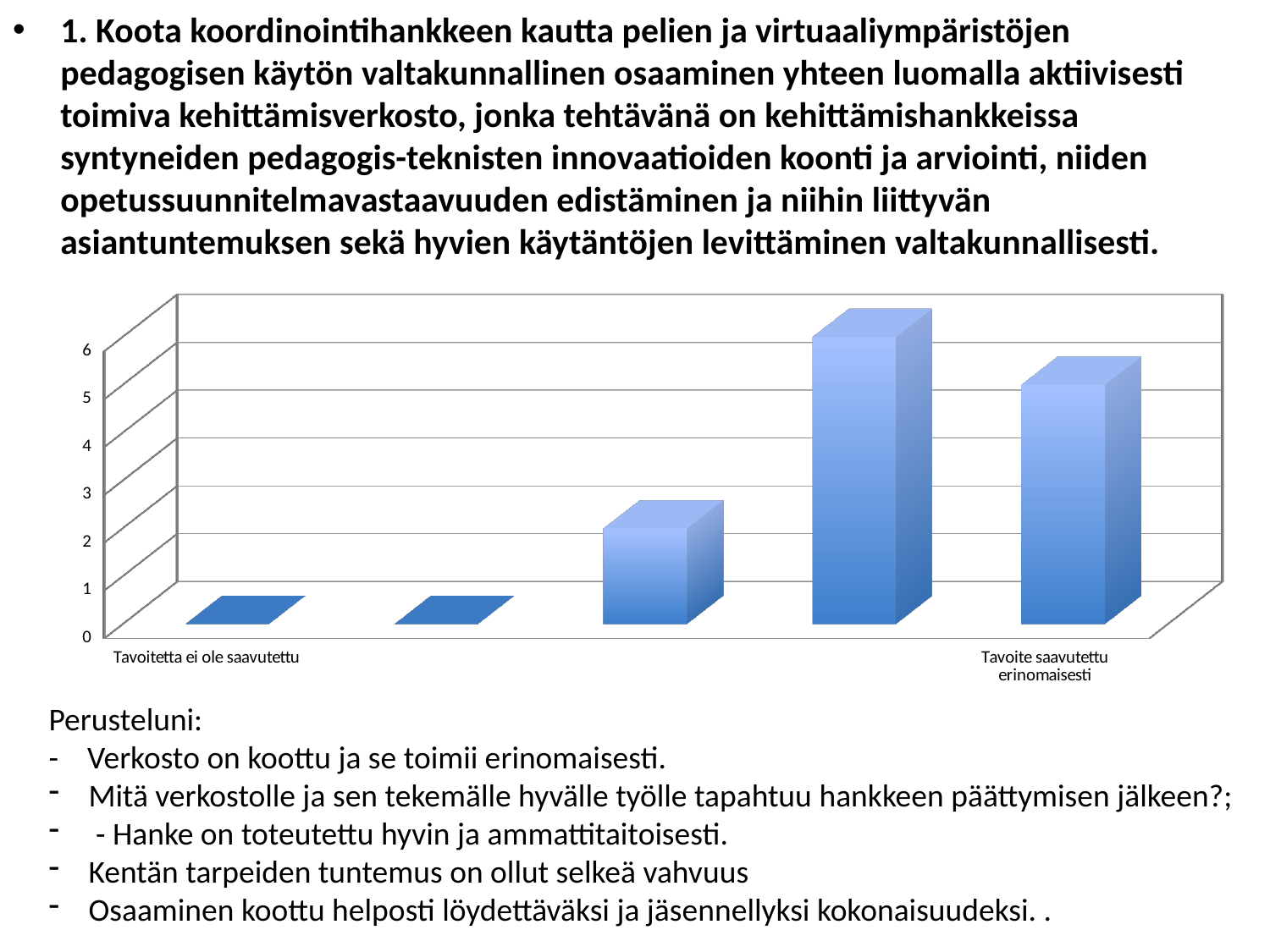
Which bar is the tallest in the chart? the fourth bar Is the value for "Tavoite saavutettu erinomaisesti" greater or less than 3? greater What colour are the bars in the chart? blue What is the highest value shown on the vertical axis? 6 Which is larger, the bar for "Tavoitetta ei ole saavutettu" or the bar for "Tavoite saavutettu erinomaisesti"? Tavoite saavutettu erinomaisesti What is the value of the bar labelled "Tavoitetta ei ole saavutettu"? 0 What kind of chart is shown on the slide? bar chart How many bars are plotted in the chart? 5 Is the value of the fourth bar greater or less than 4? greater Is the value of the third bar greater or less than 3? less Which is larger, the fourth bar or the bar labelled "Tavoite saavutettu erinomaisesti"? the fourth bar